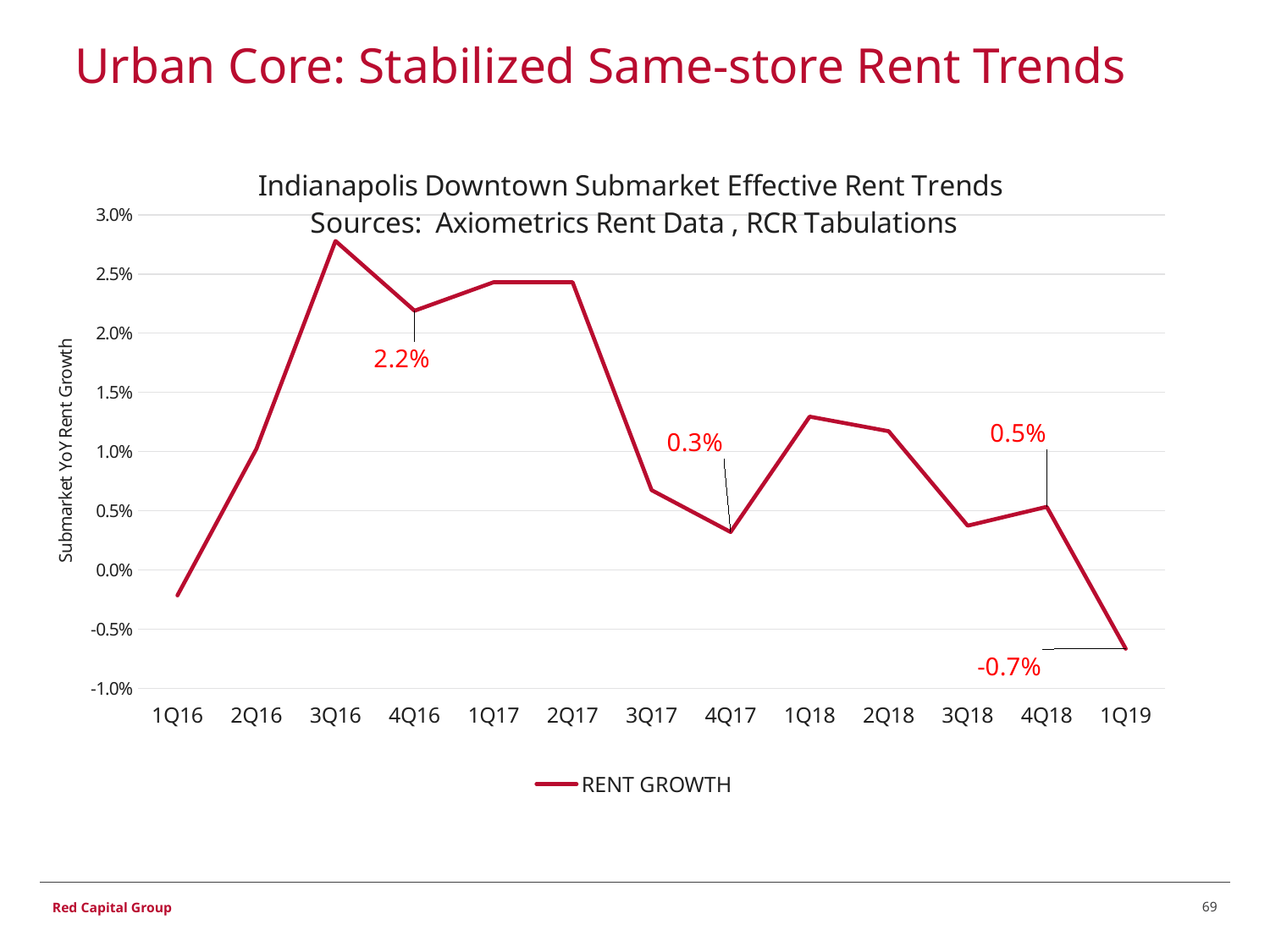
Which is larger, the value for 4Q16 or the value for 4Q18? 4Q16 What is the value for 1Q19? -0.7% What is the value for 4Q16? 2.2% Which quarter has the lowest rent growth? 1Q19 Which quarter has the highest rent growth? 3Q16 What kind of chart is shown? Line chart Is the value for 2Q17 greater or less than 2.0%? greater What is the value for 4Q18? 0.5% How many quarters are plotted on the x axis? 13 What is the value for 4Q17? 0.3% What is the difference between the values for 4Q16 and 4Q17? 1.9 percentage points Is the value for 1Q16 greater or less than 0.0%? less